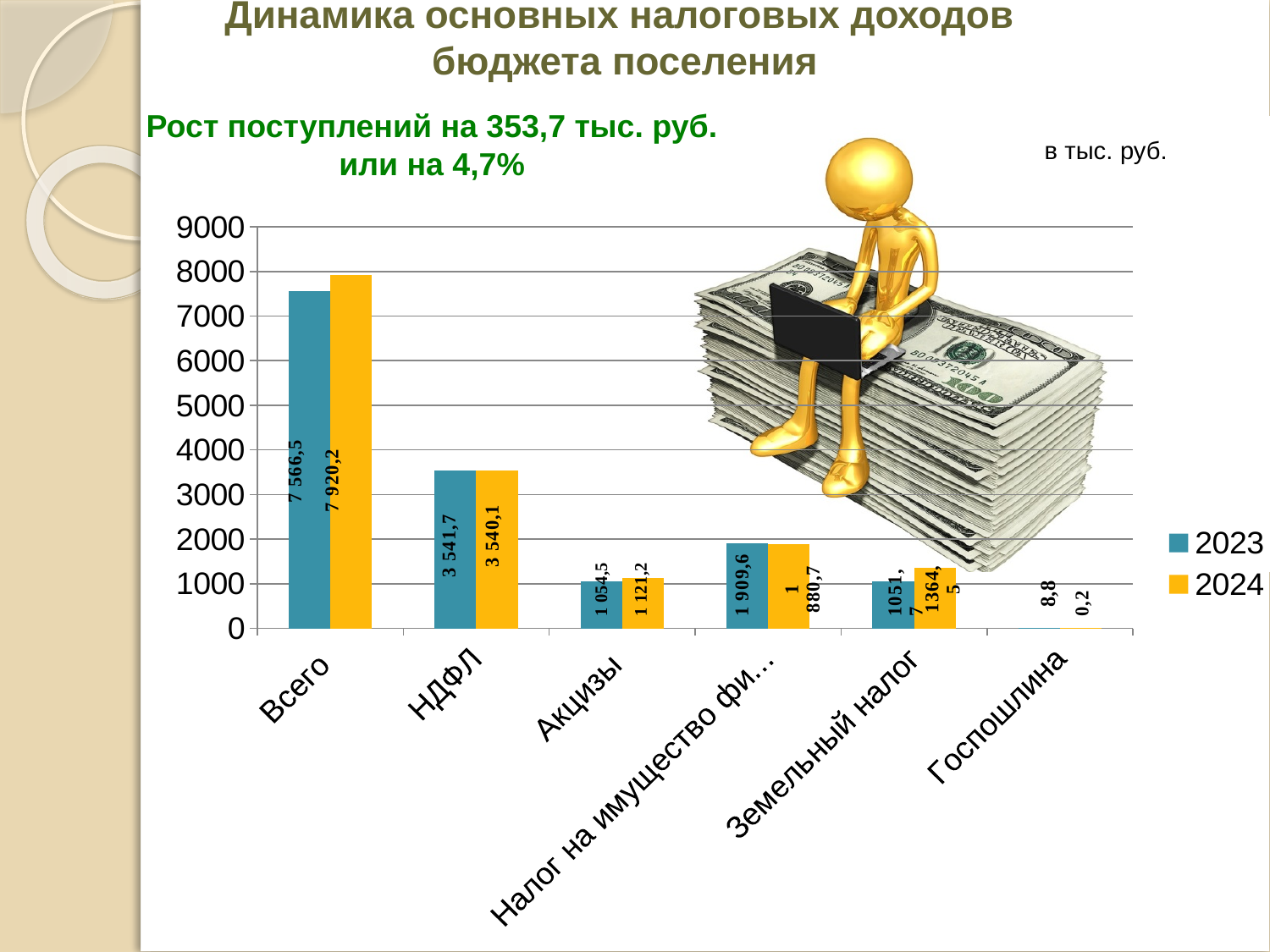
What is the value for Всего in the 2024 series? 7 920,2 What is the value for Госпошлина in the 2023 series? 8,8 What is the difference between the 2024 and 2023 values for Всего? 353,7 How many series does the legend list? 2 For Акцизы, which series has the larger value, 2023 or 2024? 2024 Which category has the highest value in the 2024 series? Всего Which category has the lowest value in the 2023 series? Госпошлина What is the value for НДФЛ in the 2023 series? 3 541,7 How many categories are shown on the x axis of the chart? 6 Is the 2024 value for Земельный налог greater or less than 1000? greater What is the value for Акцизы in the 2024 series? 1 121,2 What kind of chart is shown on the slide? bar chart